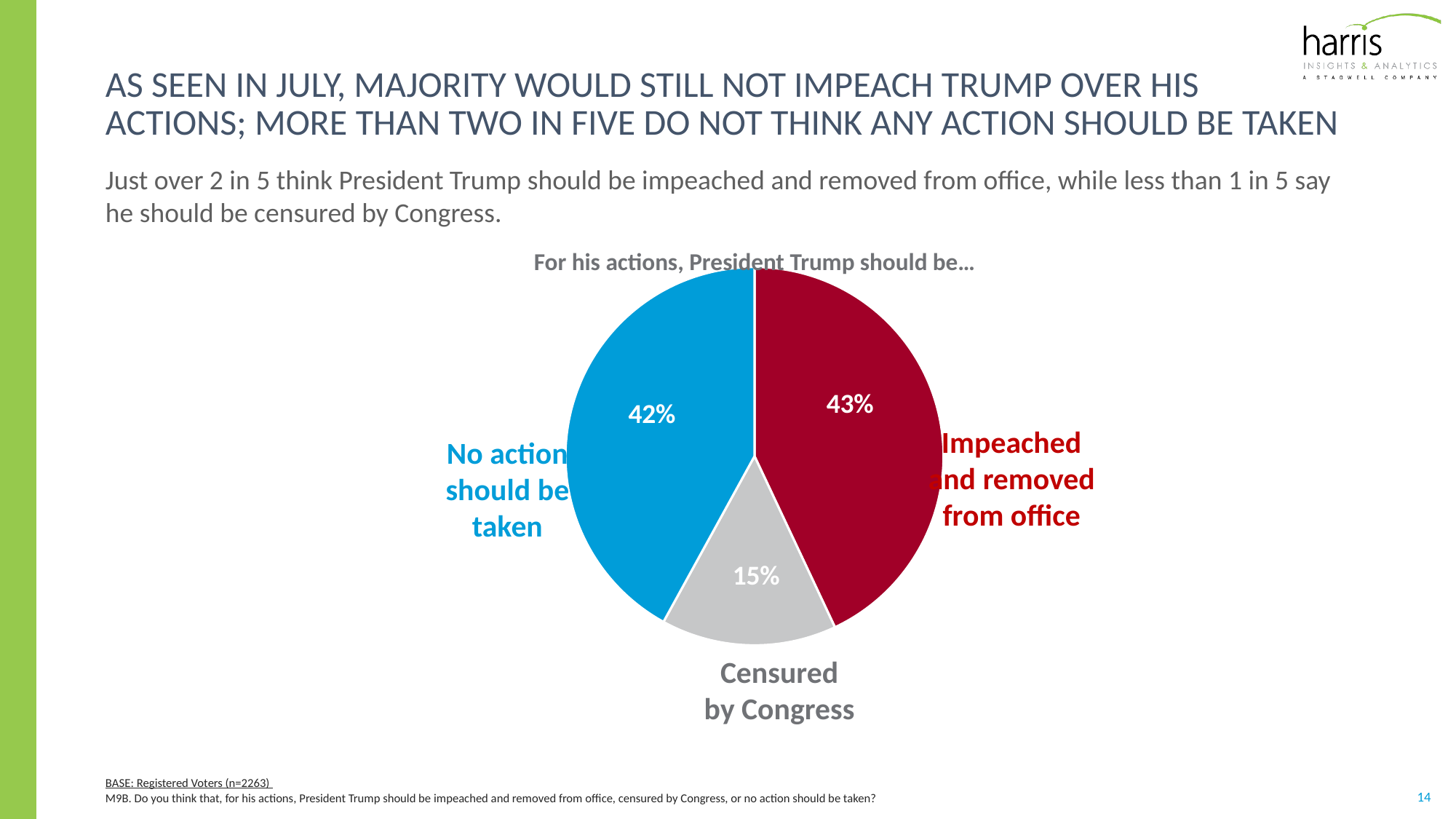
What is the title of the pie chart? For his actions, President Trump should be… Which response has the smallest share of the pie? Censured by Congress What percentage of respondents say President Trump should be impeached and removed from office? 43% What is the difference in percentage points between 'Impeached and removed from office' and 'Censured by Congress'? 28 How many slices does the pie chart have? 3 What percentage of respondents say President Trump should be censured by Congress? 15% What kind of chart is shown on the slide? pie chart What percentage of respondents say no action should be taken? 42% Which is larger: the share for 'No action should be taken' or the share for 'Censured by Congress'? No action should be taken Which response has the largest share of the pie? Impeached and removed from office What colour is the 'No action should be taken' slice? blue What is the difference in percentage points between 'No action should be taken' and 'Censured by Congress'? 27